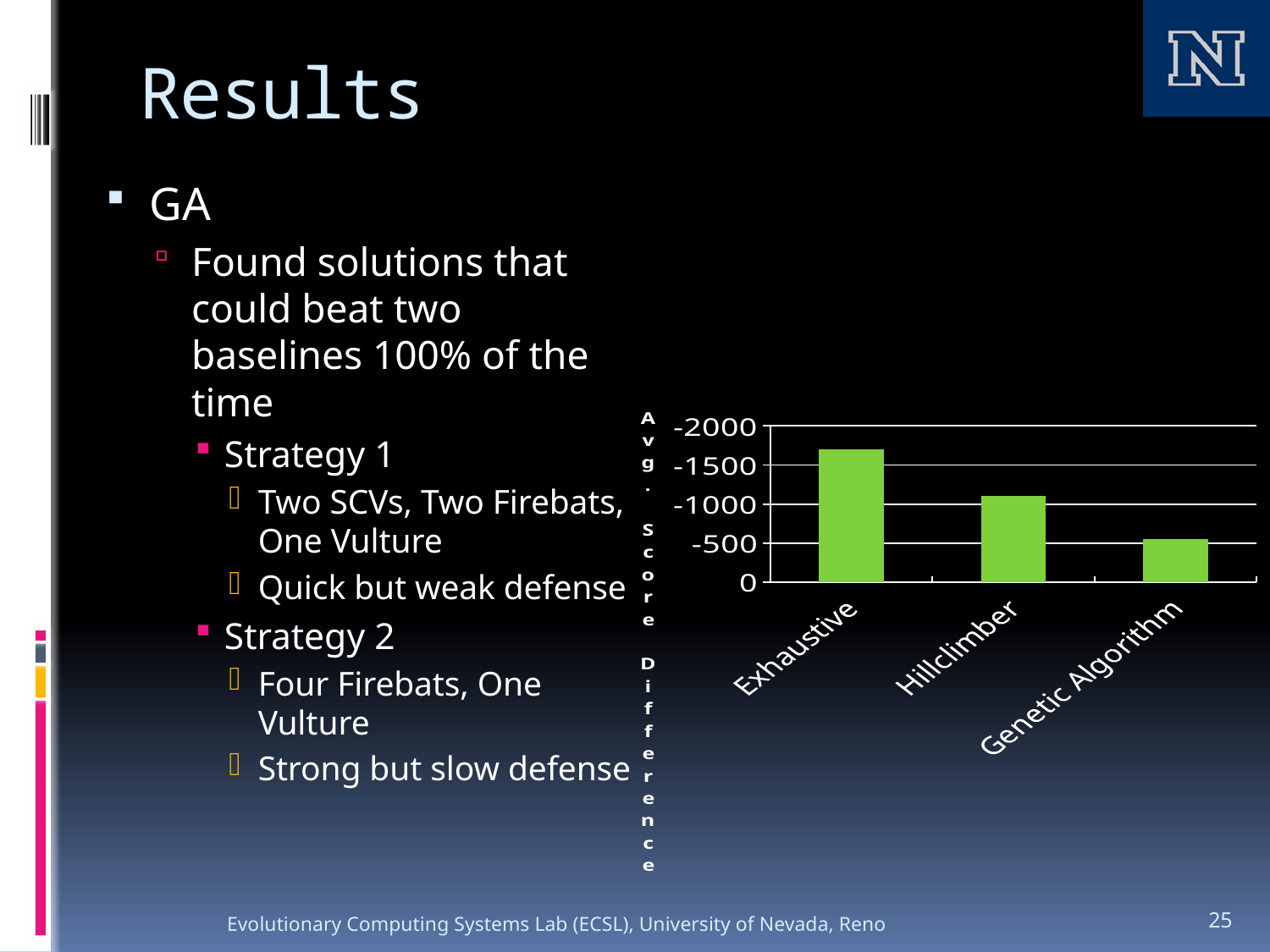
How many categories are plotted on the x axis of the chart? 3 Does the bar for Genetic Algorithm extend beyond the -1000 gridline? no Does the bar for Exhaustive extend beyond the -1500 gridline? yes Which category has the shortest bar in the chart? Genetic Algorithm What kind of chart is shown on the slide? bar chart What value is shown at the top of the vertical axis? -2000 Do the bar heights rise or fall from left to right across the x axis? fall Does the bar for Hillclimber extend beyond the -1500 gridline? no Which bar is taller, Hillclimber or Genetic Algorithm? Hillclimber What is the title of the vertical axis of the chart? Avg. Score Difference Which bar is taller, Exhaustive or Hillclimber? Exhaustive Which category has the tallest bar in the chart? Exhaustive